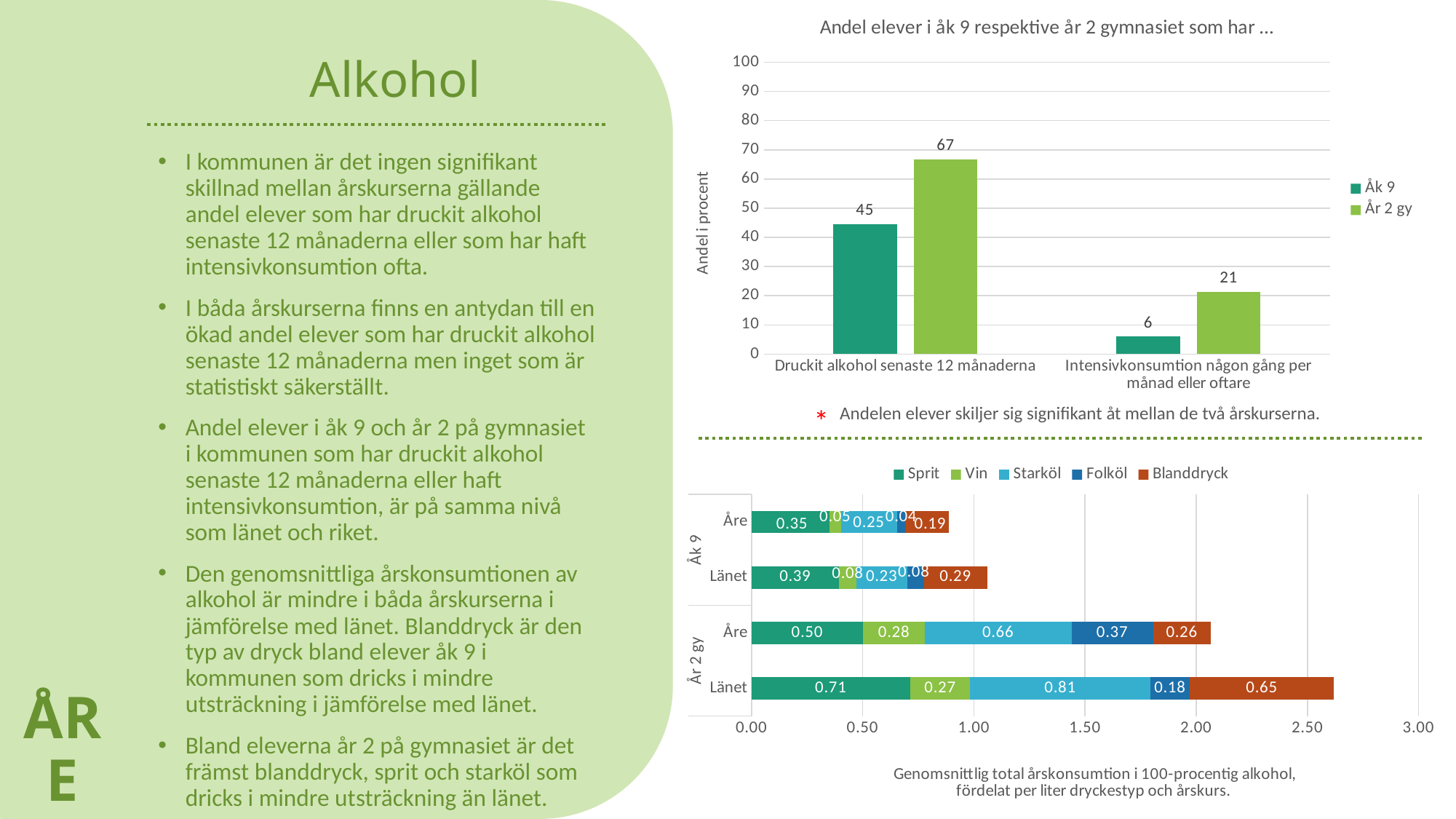
In the bottom chart, what is the total of the stacked bar for Åre in Åk 9? 0.88 In the bottom chart, what is the Blanddryck value for Åre in Åk 9? 0.19 In the top chart, what is the value for Åk 9 for 'Druckit alkohol senaste 12 månaderna'? 45 In the top chart, what is the value for År 2 gy for 'Intensivkonsumtion någon gång per månad eller oftare'? 21 In the top chart, what is the difference between År 2 gy and Åk 9 for 'Druckit alkohol senaste 12 månaderna'? 22 In the bottom chart, how many series does the legend list? 5 What kind of chart is the top chart? Bar chart In the bottom chart, which is larger: the Sprit value for Åre in År 2 gy or the Sprit value for Länet in År 2 gy? Länet In the bottom chart, what is the Starköl value for Länet in År 2 gy? 0.81 In the bottom chart, what is the total of the stacked bar for Länet in År 2 gy? 2.62 In the top chart, how many series does the legend list? 2 In the top chart, which series has the lowest value overall? Åk 9